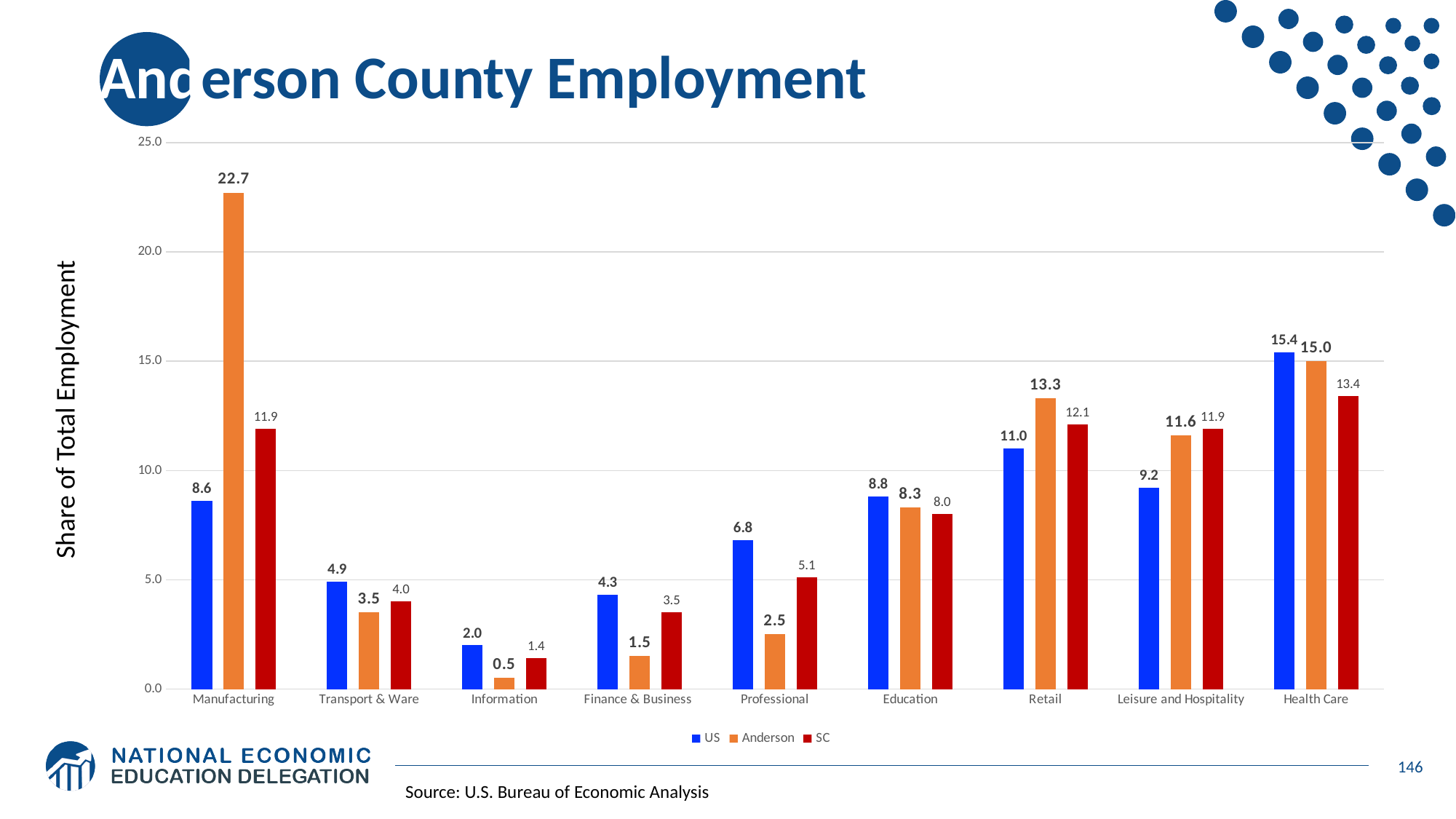
What is the y-axis label of the chart? Share of Total Employment What is the US value for Health Care? 15.4 What is the difference between the Anderson and SC values for Manufacturing? 10.8 Which category has the lowest Anderson value? Information Which category has the highest Anderson value? Manufacturing What kind of chart is shown on the slide? bar chart How many categories are shown on the x axis? 9 Which is larger for Professional, the US value or the Anderson value? US How many series does the legend list? 3 What is the Anderson value for Manufacturing? 22.7 What is the SC value for Retail? 12.1 Is the Anderson value for Retail greater or less than 10.0? greater